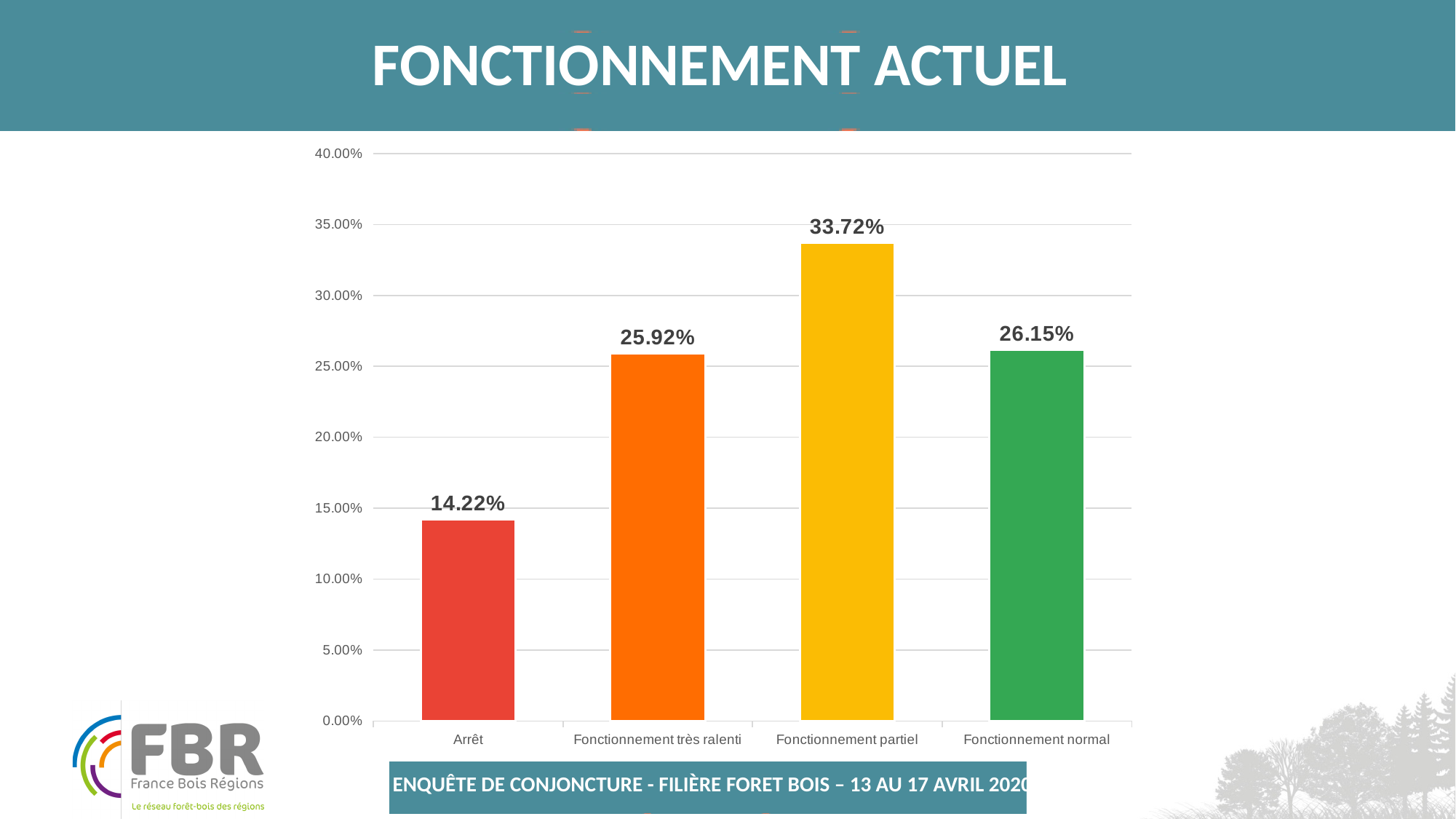
What kind of chart is shown on the slide? Bar chart What is the difference between Fonctionnement partiel and Arrêt? 19.50% How many categories are shown on the chart? 4 What is the value for Fonctionnement normal? 26.15% What is the value for Fonctionnement partiel? 33.72% What is the difference between Fonctionnement normal and Fonctionnement très ralenti? 0.23% Which is larger, Fonctionnement partiel or Fonctionnement normal? Fonctionnement partiel What is the value for Arrêt? 14.22% Which category has the highest value? Fonctionnement partiel Is the value for Arrêt greater or less than 15.00%? less What is the value for Fonctionnement très ralenti? 25.92% Which category has the lowest value? Arrêt